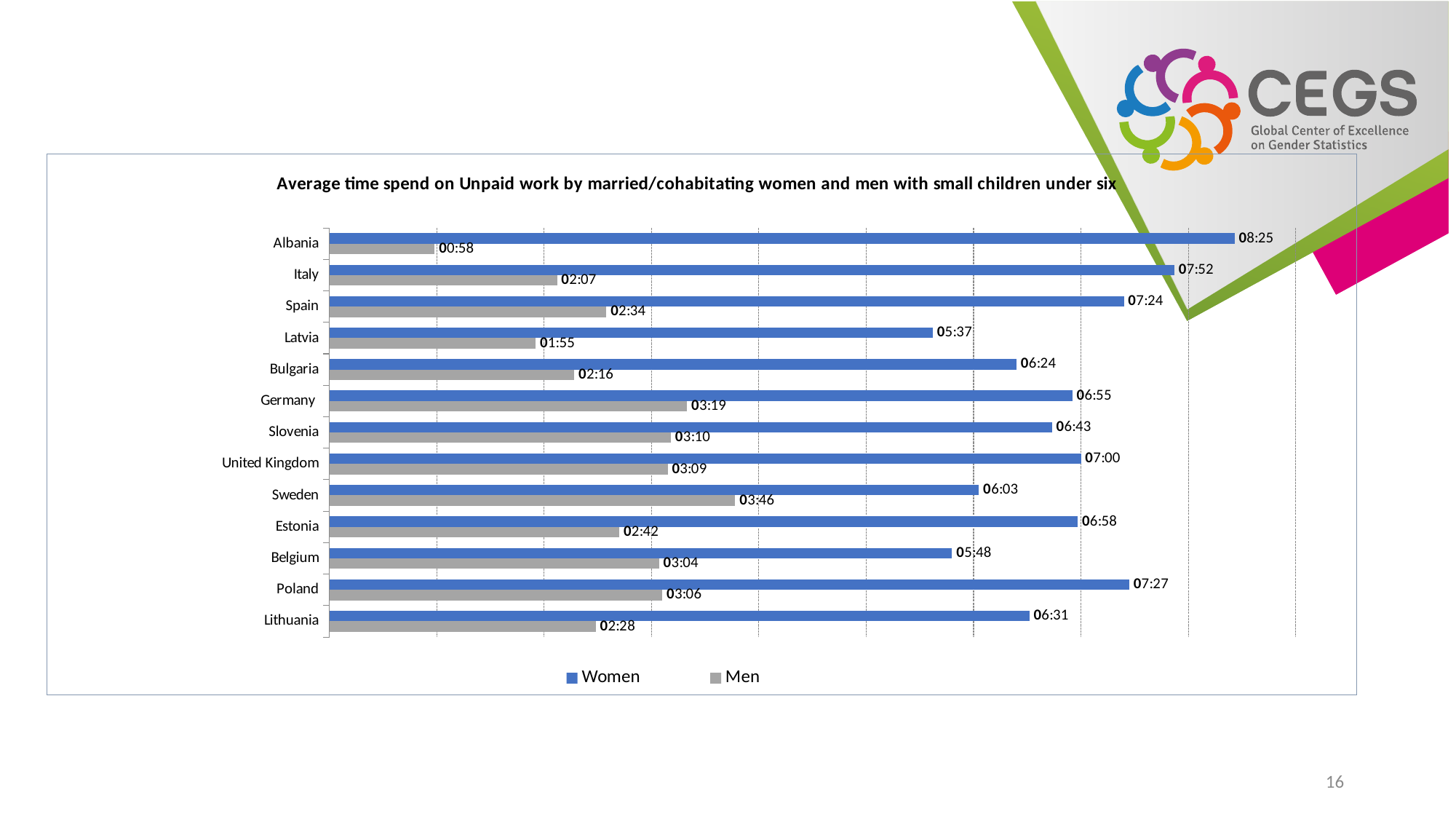
What is the difference between the Women and Men values for Albania? 07:27 Which country has the lowest value for Men? Albania Which country has the highest value for Women? Albania How many series does the legend list? 2 How many countries are shown in the chart? 13 What is the value for Men in Sweden? 03:46 What is the value for Women in Poland? 07:27 What is the value for Men in Latvia? 01:55 What is the value for Women in Albania? 08:25 Which country has the lowest value for Women? Latvia Which is larger, the Women value for Italy or the Women value for Spain? Italy Which country has the highest value for Men? Sweden